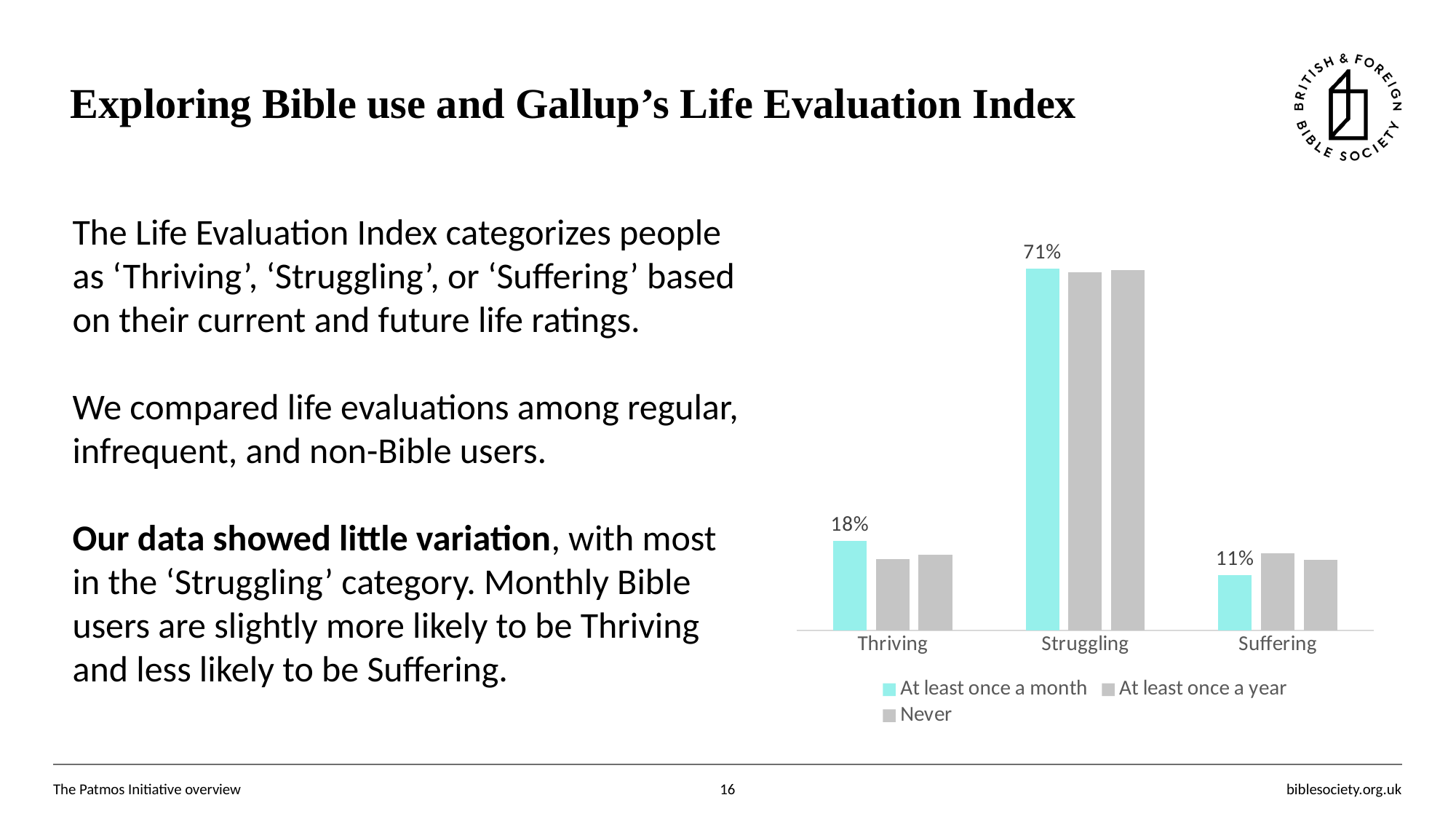
What is the value for 'At least once a month' in the Struggling category? 71% Which category has the highest value for the 'At least once a month' series? Struggling In the Suffering category, which is larger: 'At least once a month' or 'Never'? Never What is the difference between the 'At least once a month' values for Struggling and Thriving? 53% What is the difference between the 'At least once a month' values for Thriving and Suffering? 7% What is the value for 'At least once a month' in the Thriving category? 18% Which category has the lowest value for the 'At least once a month' series? Suffering What is the value for 'At least once a month' in the Suffering category? 11% How many categories are shown on the x axis of the chart? 3 How many series does the chart's legend list? 3 In the Thriving category, which is larger: 'At least once a month' or 'At least once a year'? At least once a month What kind of chart is shown on the slide? bar chart